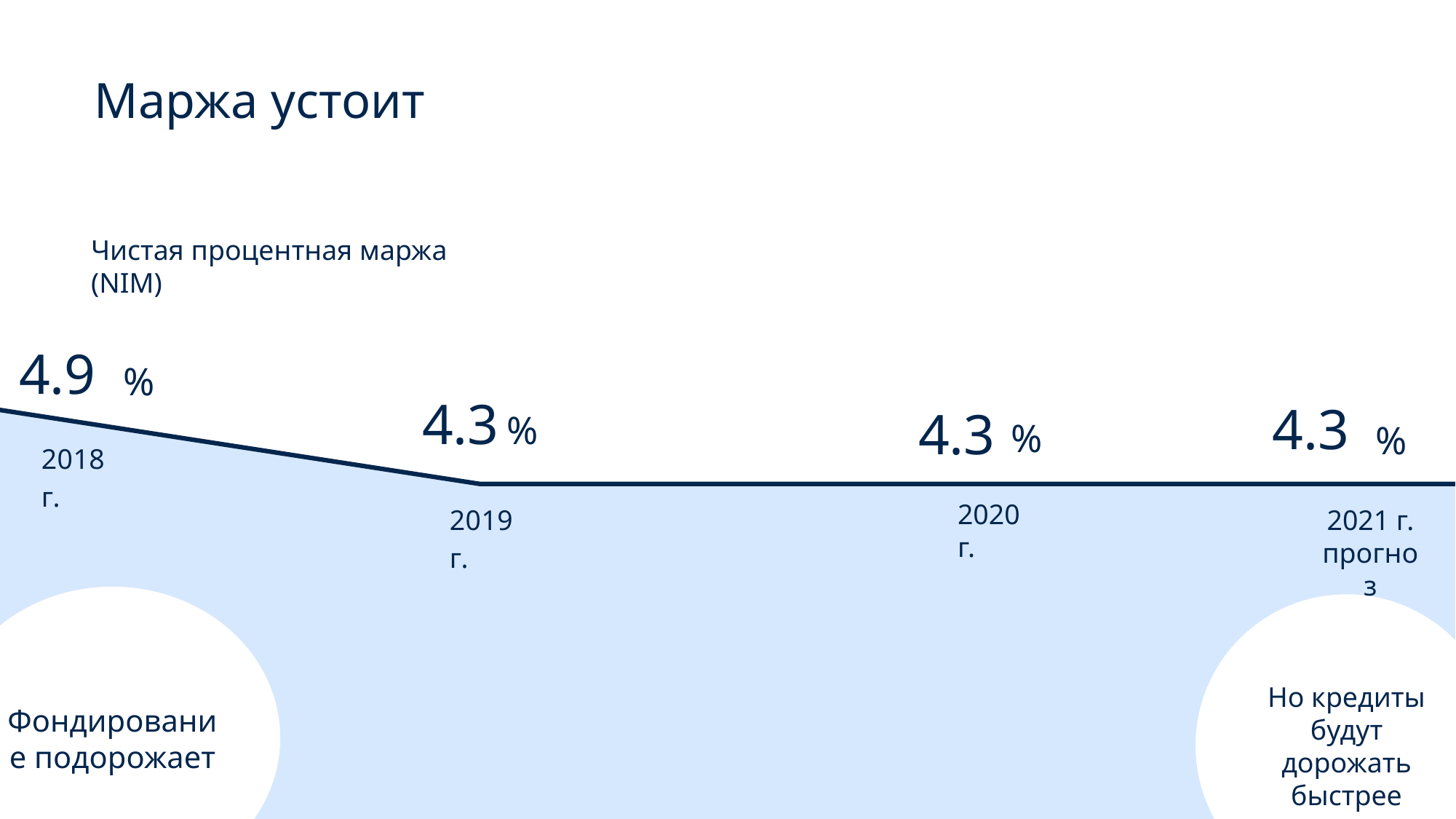
How many years (data points) are shown on the chart? 4 What is the forecast NIM value shown for 2021? 4.3% What kind of chart is shown on the slide? Area chart What is the NIM value shown for 2020? 4.3% What is the title of the slide? Маржа устоит What is the difference between the NIM value for 2018 and the NIM value for 2019? 0.6% What metric does the chart show, according to its label? Чистая процентная маржа (NIM) What is the NIM value shown for 2019? 4.3% Which year has the highest NIM value on the chart? 2018 Does the NIM value rise or fall from 2018 to 2019? Fall What is the net interest margin (NIM) value shown for 2018? 4.9% Which is larger, the NIM value for 2018 or the NIM value for 2020? 2018